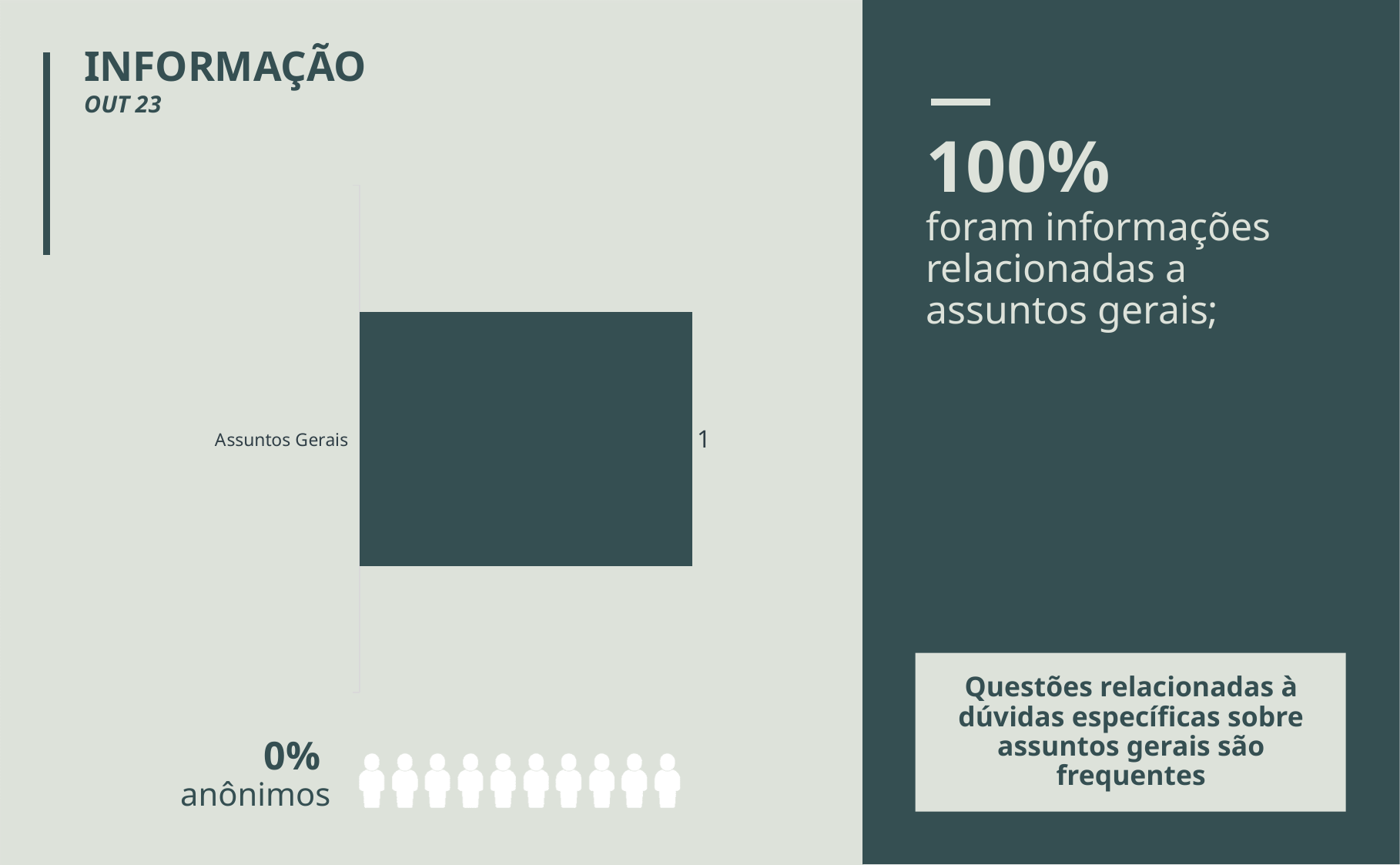
What kind of chart is shown on the slide? bar chart Are the bars in the chart horizontal or vertical? horizontal What is the value for Assuntos Gerais in the bar chart? 1 What is the label of the only category in the bar chart? Assuntos Gerais Which category has the highest value in the bar chart? Assuntos Gerais How many categories does the bar chart show? 1